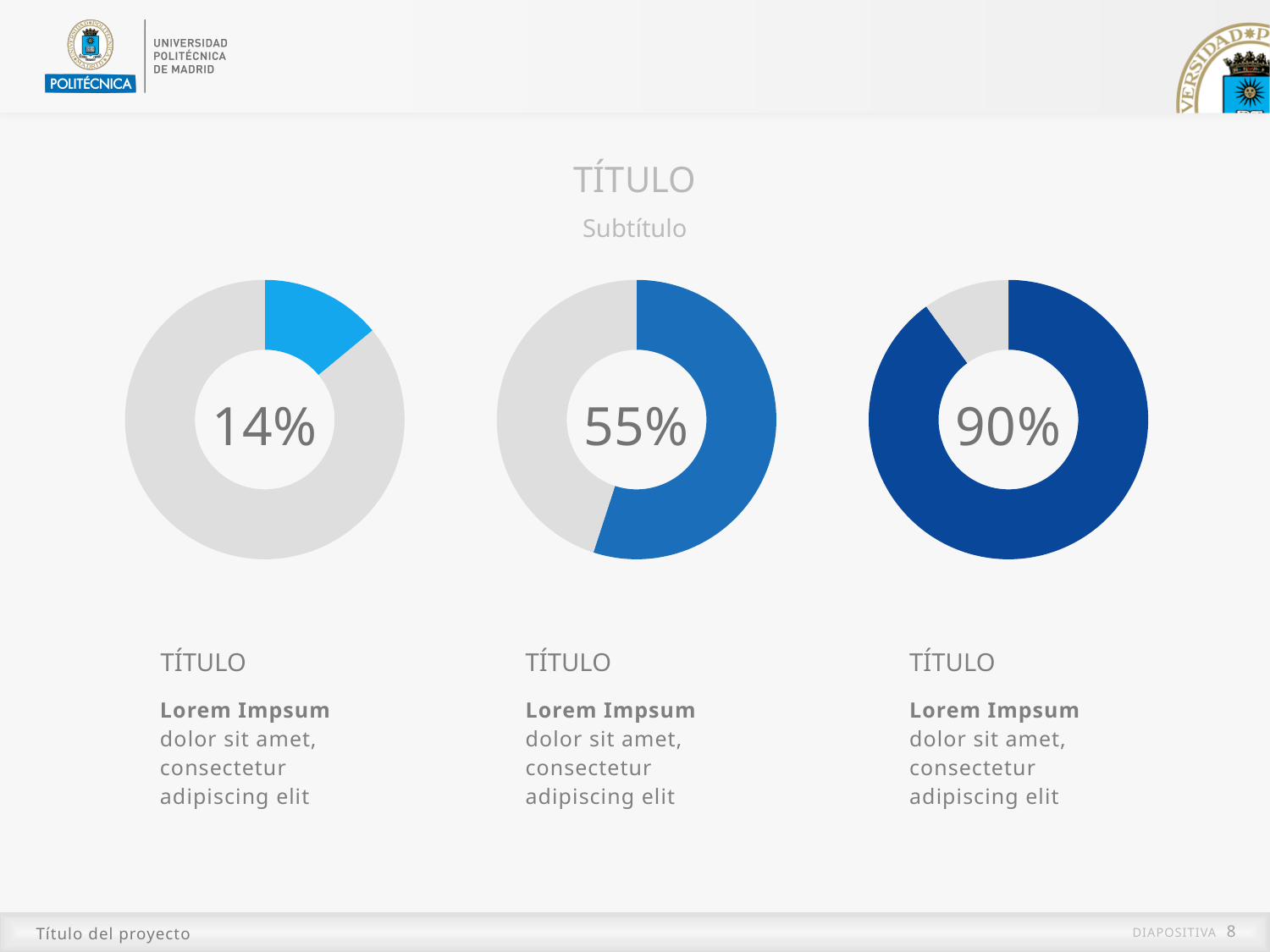
In the left donut chart, what share of the ring is filled with the coloured segment? 14% Which of the three donut charts shows the highest percentage: left, middle or right? right What kind of chart is used for the three figures on the slide? donut chart Which of the three donut charts shows the lowest percentage: left, middle or right? left How many donut charts are on the slide? 3 What is the difference between the percentage in the middle donut chart and the percentage in the left donut chart? 41% What percentage is shown in the centre of the middle donut chart? 55% What is the difference between the percentage in the right donut chart and the percentage in the left donut chart? 76% What percentage is shown in the centre of the right donut chart? 90% Which donut chart uses the darkest blue for its filled segment: left, middle or right? right Which shows a larger percentage, the middle donut chart or the right donut chart? right What percentage is shown in the centre of the left donut chart? 14%